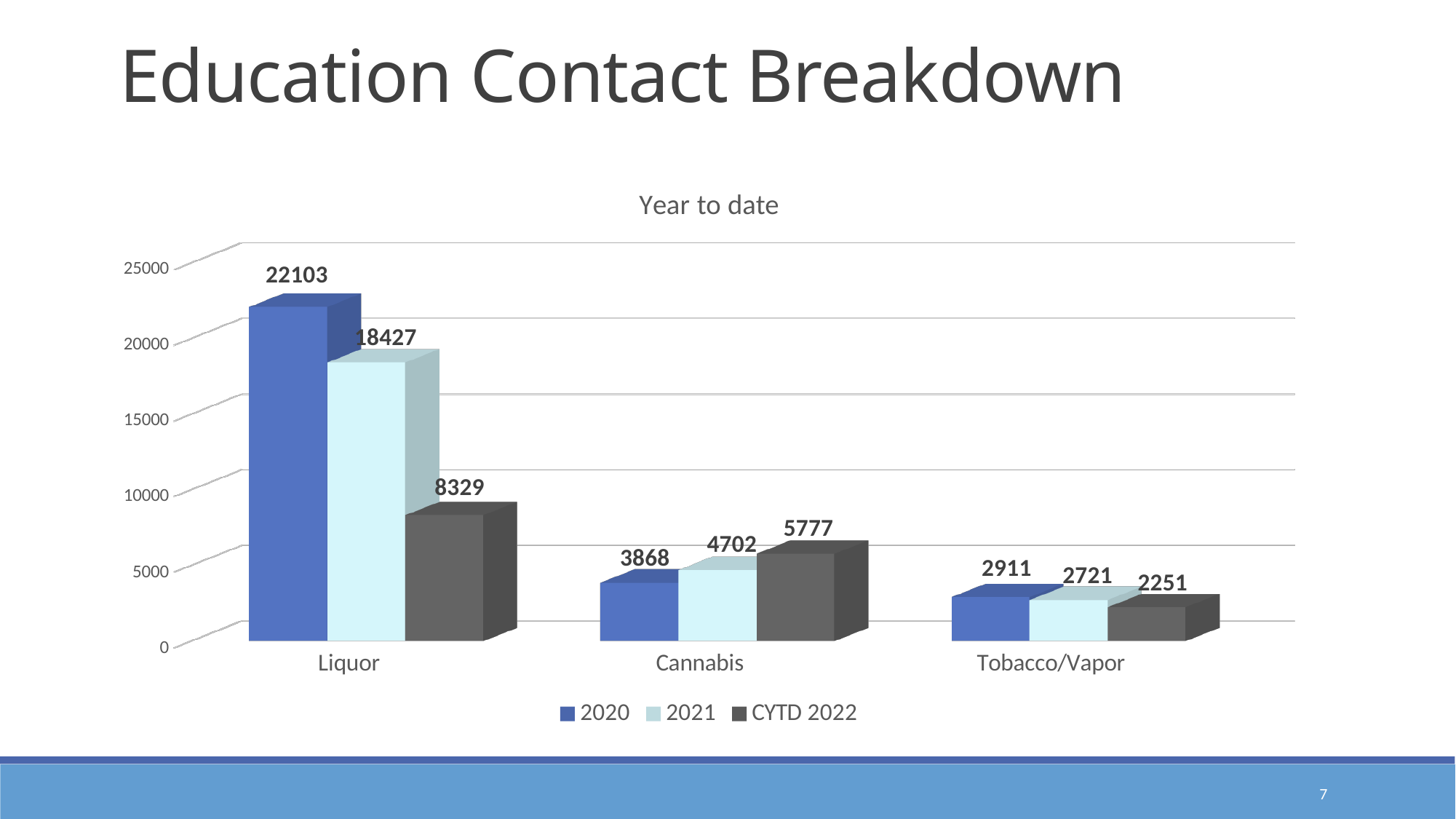
What is the title of the chart? Year to date How many series does the legend list? 3 What is the CYTD 2022 value for Cannabis? 5777 How many categories are shown on the x axis? 3 Which category has the highest 2020 value? Liquor What is the 2020 value for Liquor? 22103 What kind of chart is shown on the slide? Bar chart Which is larger for Cannabis, the 2020 value or the CYTD 2022 value? CYTD 2022 Which category has the lowest CYTD 2022 value? Tobacco/Vapor What is the difference between the 2020 and 2021 values for Liquor? 3676 Is the 2021 value for Liquor greater or less than 15000? greater What is the 2021 value for Tobacco/Vapor? 2721